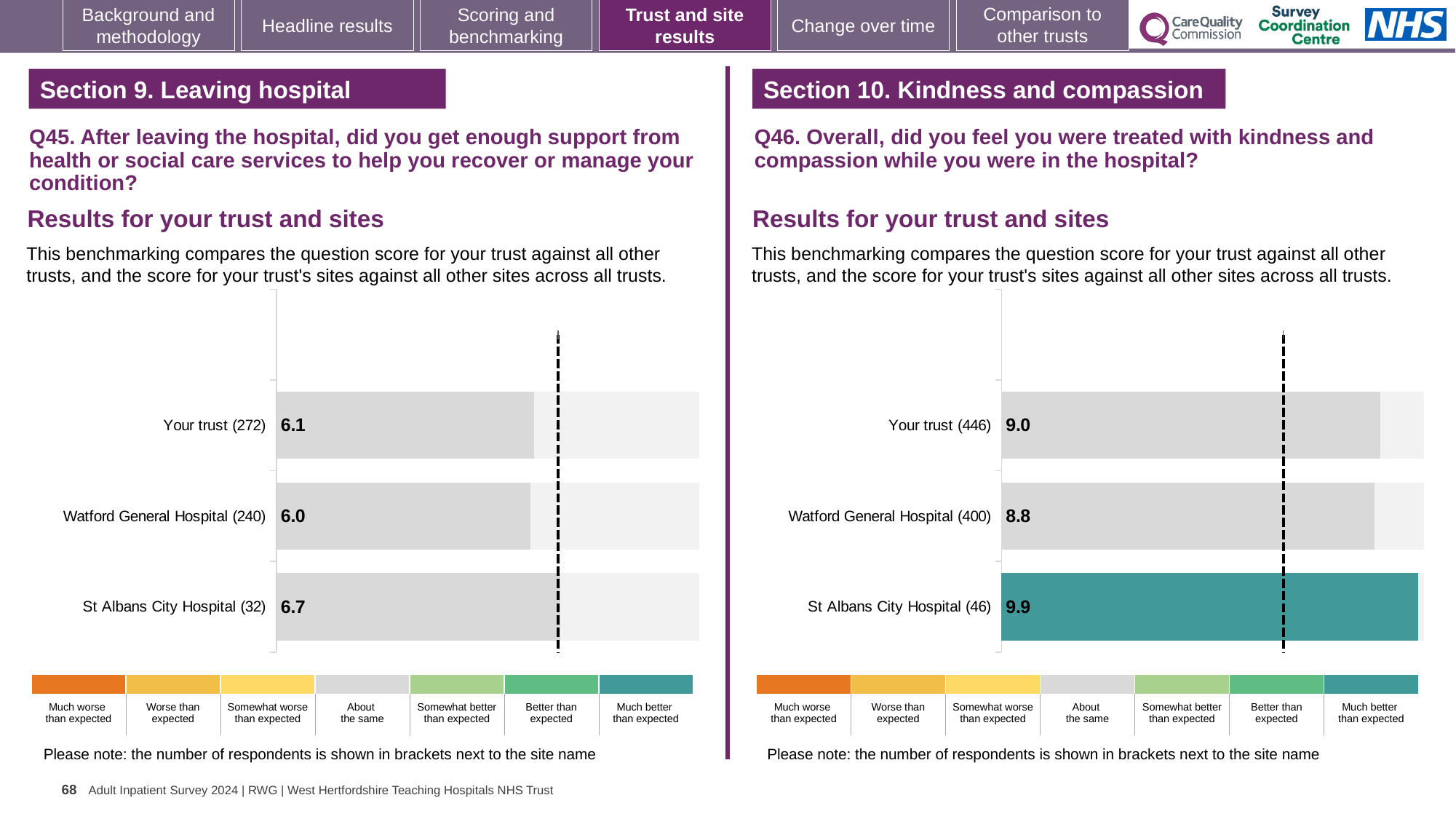
On the Q45 chart (Section 9, Leaving hospital), what is the difference between the scores for St Albans City Hospital and Watford General Hospital? 0.7 On the Q45 chart (Section 9, Leaving hospital), what is the score for Your trust? 6.1 On the Q45 chart (Section 9, Leaving hospital), which site or trust has the lowest score? Watford General Hospital On the Q46 chart (Section 10, Kindness and compassion), what is the difference between the scores for Your trust and Watford General Hospital? 0.2 On the Q46 chart (Section 10, Kindness and compassion), what is the score for Watford General Hospital? 8.8 How many bars are plotted on the Q45 chart (Section 9, Leaving hospital)? 3 On the Q45 chart (Section 9, Leaving hospital), which site or trust has the highest score? St Albans City Hospital On the Q46 chart (Section 10, Kindness and compassion), what is the score for St Albans City Hospital? 9.9 What kind of chart is used on the Q46 chart (Section 10, Kindness and compassion)? bar chart On the Q46 chart (Section 10, Kindness and compassion), is the score for Your trust larger or smaller than the score for St Albans City Hospital? smaller On the Q45 chart (Section 9, Leaving hospital), what is the score for St Albans City Hospital? 6.7 On the Q46 chart (Section 10, Kindness and compassion), which site or trust has the highest score? St Albans City Hospital